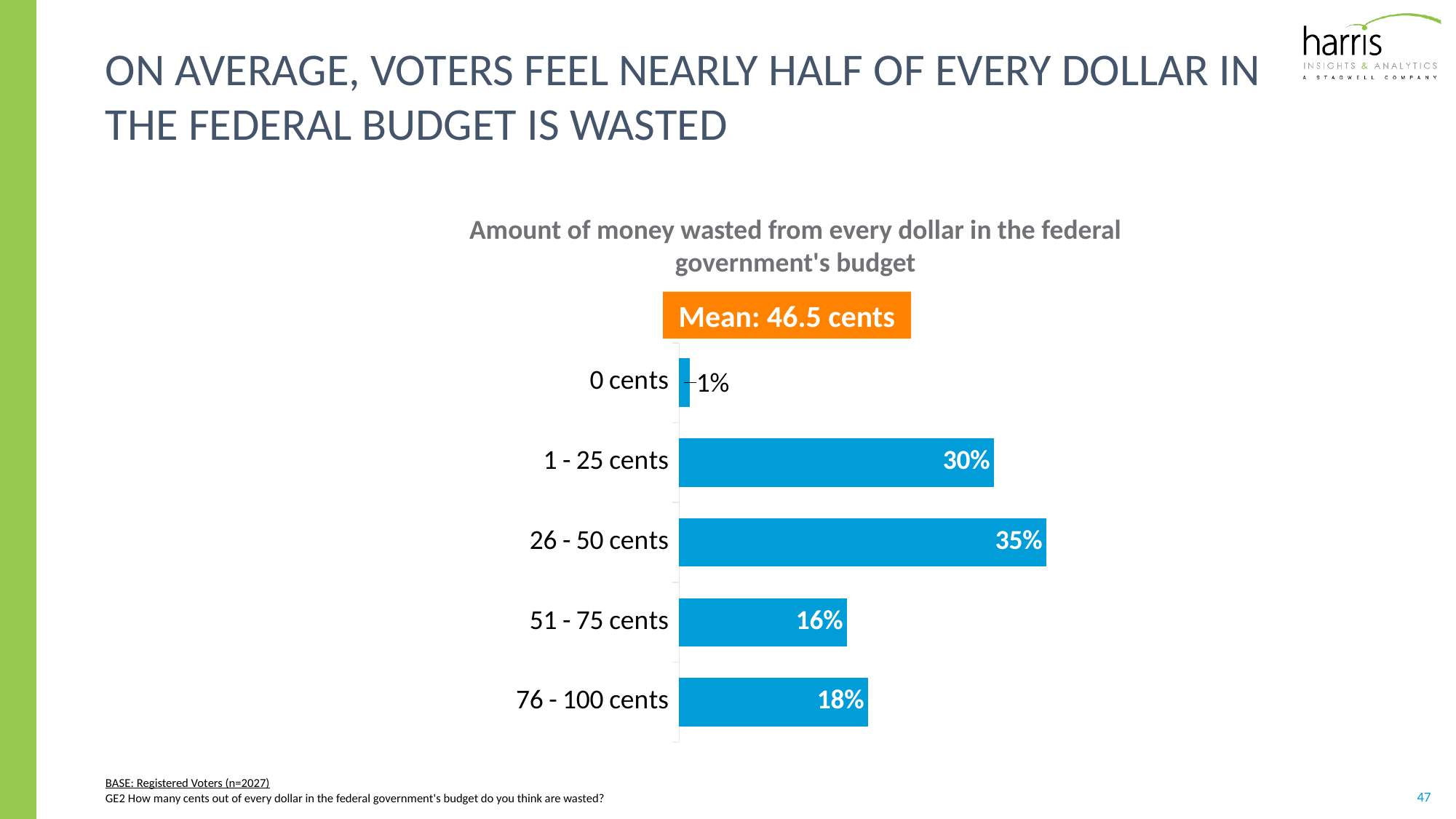
What percentage of voters said 1 - 25 cents of every dollar is wasted? 30% Which category has the highest percentage? 26 - 50 cents What kind of chart is shown on the slide? Bar chart What mean value is shown above the chart? Mean: 46.5 cents Which category has the lowest percentage? 0 cents What is the title of the chart? Amount of money wasted from every dollar in the federal government's budget What percentage of voters said 26 - 50 cents of every dollar is wasted? 35% How many categories are shown in the chart? 5 Which is larger, the percentage for 51 - 75 cents or for 76 - 100 cents? 76 - 100 cents What percentage of voters said 0 cents of every dollar is wasted? 1% What is the difference between the percentages for 26 - 50 cents and 1 - 25 cents? 5% What percentage of voters said 76 - 100 cents of every dollar is wasted? 18%